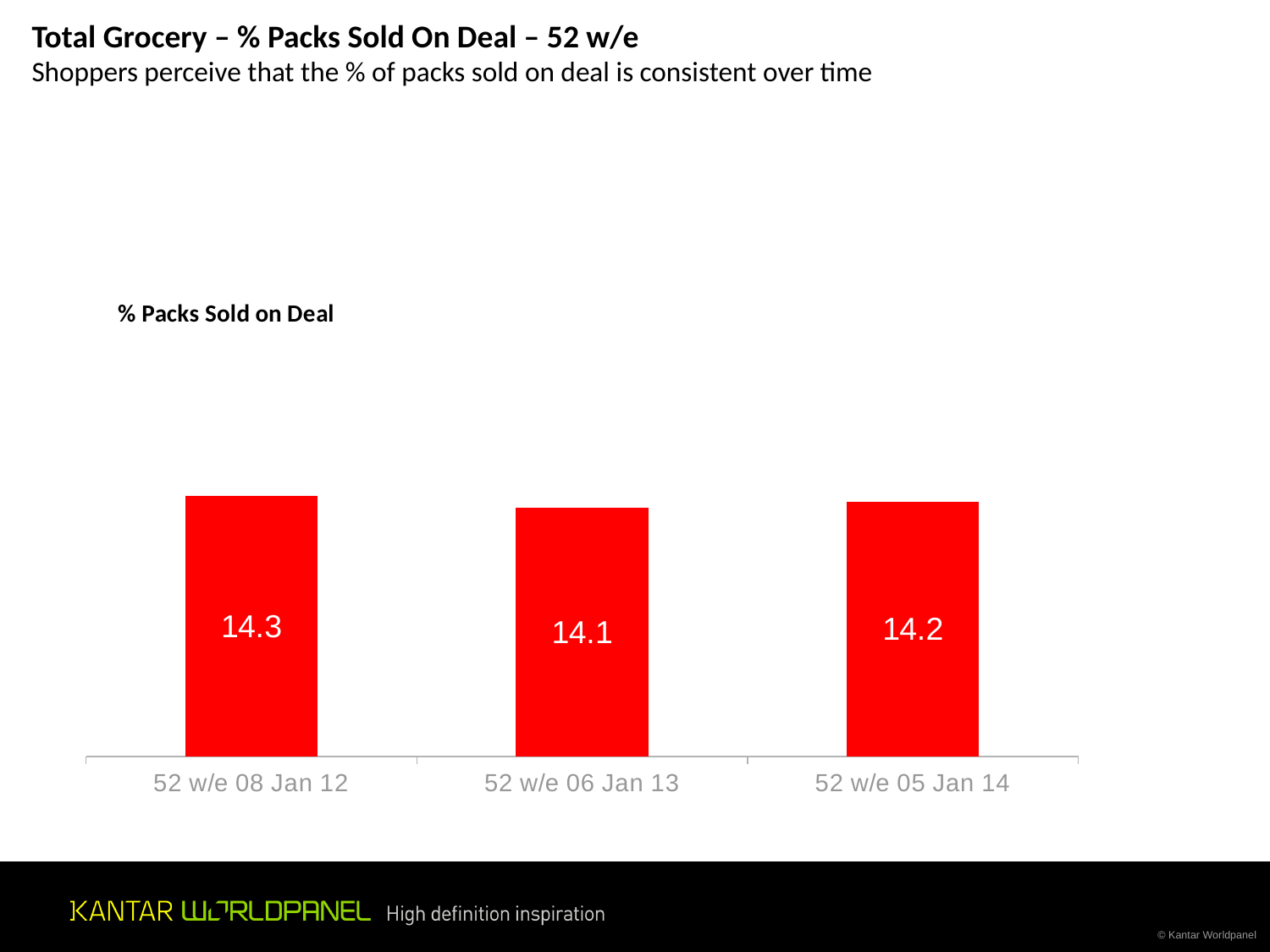
Which period has the highest % of packs sold on deal? 52 w/e 08 Jan 12 What colour are the bars in the chart? Red Which is larger, the value for 52 w/e 08 Jan 12 or the value for 52 w/e 05 Jan 14? 52 w/e 08 Jan 12 What kind of chart is shown on the slide? Bar chart What is the value for 52 w/e 06 Jan 13? 14.1 What is the difference between the values for 52 w/e 08 Jan 12 and 52 w/e 06 Jan 13? 0.2 What is the difference between the values for 52 w/e 05 Jan 14 and 52 w/e 06 Jan 13? 0.1 What is the value for 52 w/e 08 Jan 12? 14.3 Which period has the lowest % of packs sold on deal? 52 w/e 06 Jan 13 What is the value for 52 w/e 05 Jan 14? 14.2 How many periods are shown on the chart? 3 What is the title of the chart? % Packs Sold on Deal